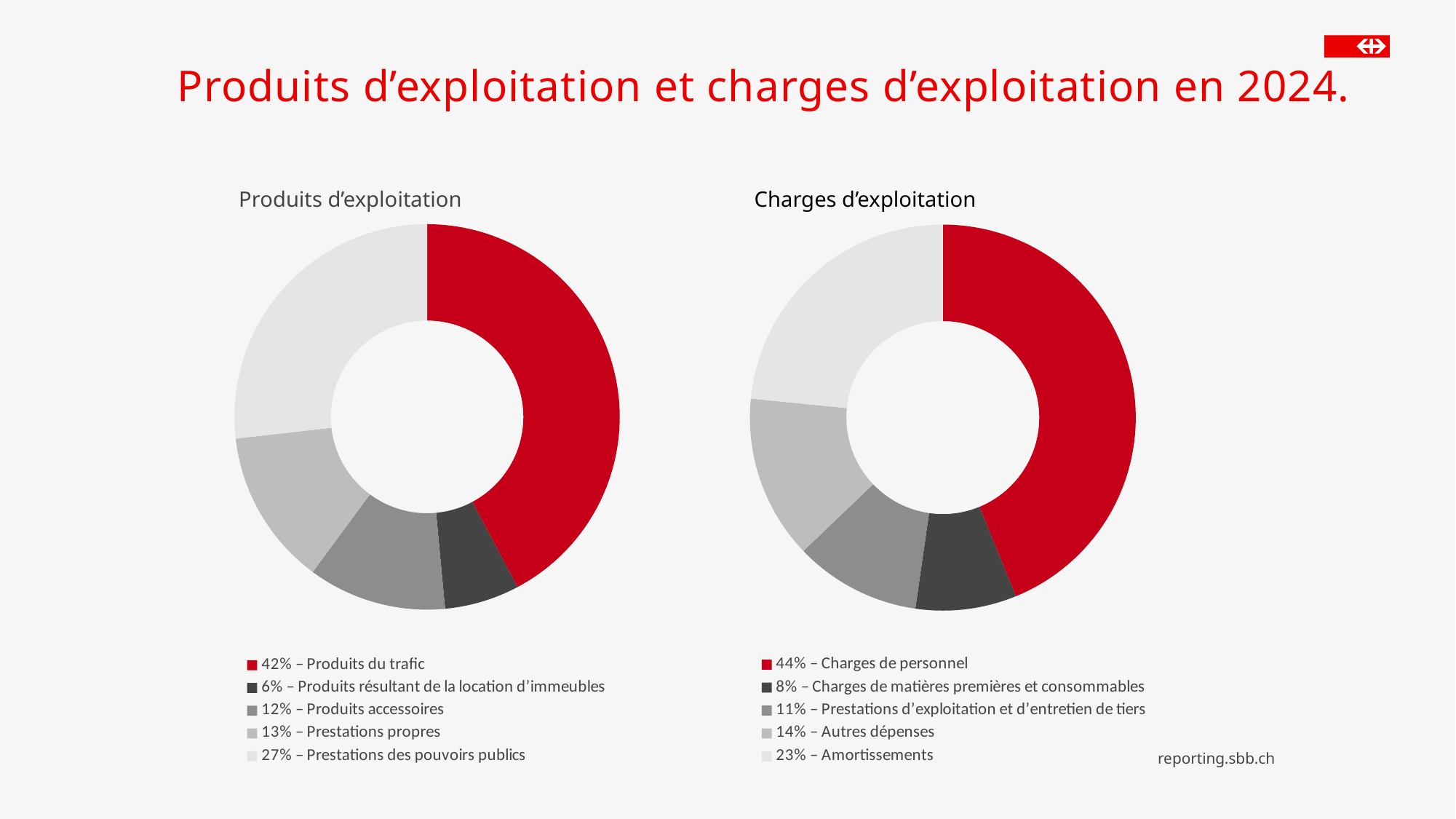
In the 'Produits d'exploitation' chart, which category has the smallest share? Produits résultant de la location d'immeubles In the 'Charges d'exploitation' chart, what is the difference between 'Charges de personnel' and 'Autres dépenses'? 30% In the 'Produits d'exploitation' chart, what colour is the 'Produits du trafic' slice? Red In the 'Charges d'exploitation' chart, which category has the smallest share? Charges de matières premières et consommables In the 'Charges d'exploitation' chart, what share is 'Amortissements'? 23% In the 'Produits d'exploitation' chart, what share is 'Produits du trafic'? 42% How many categories does the 'Produits d'exploitation' chart show? 5 How many categories does the 'Charges d'exploitation' chart show? 5 What kind of chart is the 'Charges d'exploitation' chart? Pie (doughnut) chart In the 'Produits d'exploitation' chart, what is the difference between 'Prestations des pouvoirs publics' and 'Prestations propres'? 14% In the 'Produits d'exploitation' chart, which category has the largest share? Produits du trafic In the 'Charges d'exploitation' chart, which is larger: 'Prestations d'exploitation et d'entretien de tiers' or 'Autres dépenses'? Autres dépenses